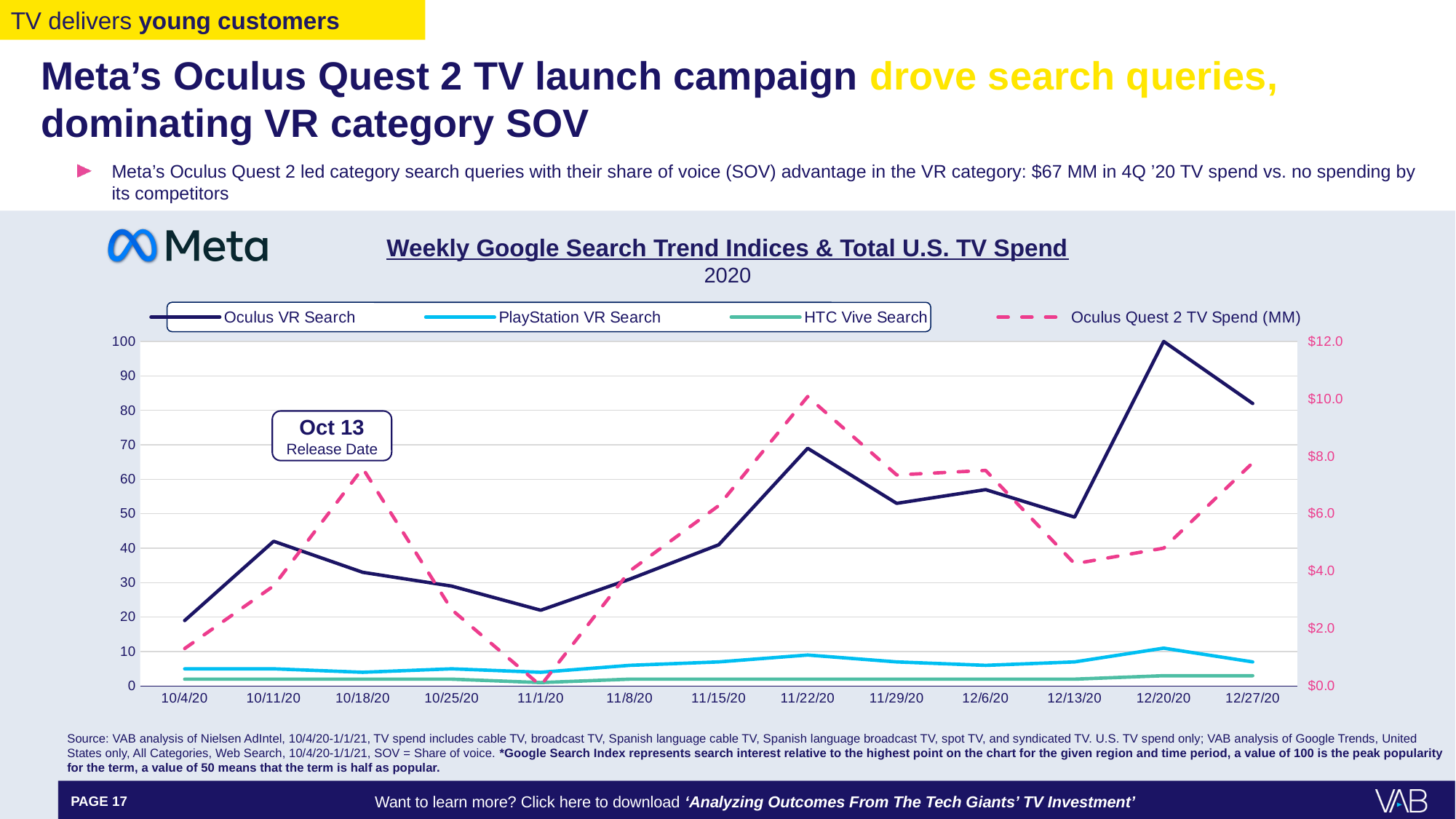
Is the Oculus VR Search value for 11/1/20 greater or less than 30? less Is the Oculus VR Search value for 11/22/20 greater or less than 60? greater How many weekly dates are shown on the x axis of the chart? 13 Which is larger on 11/22/20, the Oculus VR Search value or the PlayStation VR Search value? Oculus VR Search Does the Oculus VR Search line rise or fall from 12/20/20 to 12/27/20? Fall On which date is the Oculus Quest 2 TV Spend (MM) at its highest? 11/22/20 How many series does the chart legend list? 4 What kind of chart is shown on the slide? Line chart What is the Oculus VR Search index value for the week of 12/20/20? 100 On which date is the Oculus Quest 2 TV Spend (MM) at its lowest? 11/1/20 On which date does the Oculus VR Search line reach its highest value? 12/20/20 Is the Oculus Quest 2 TV Spend (MM) for 11/22/20 greater or less than $8.0? greater